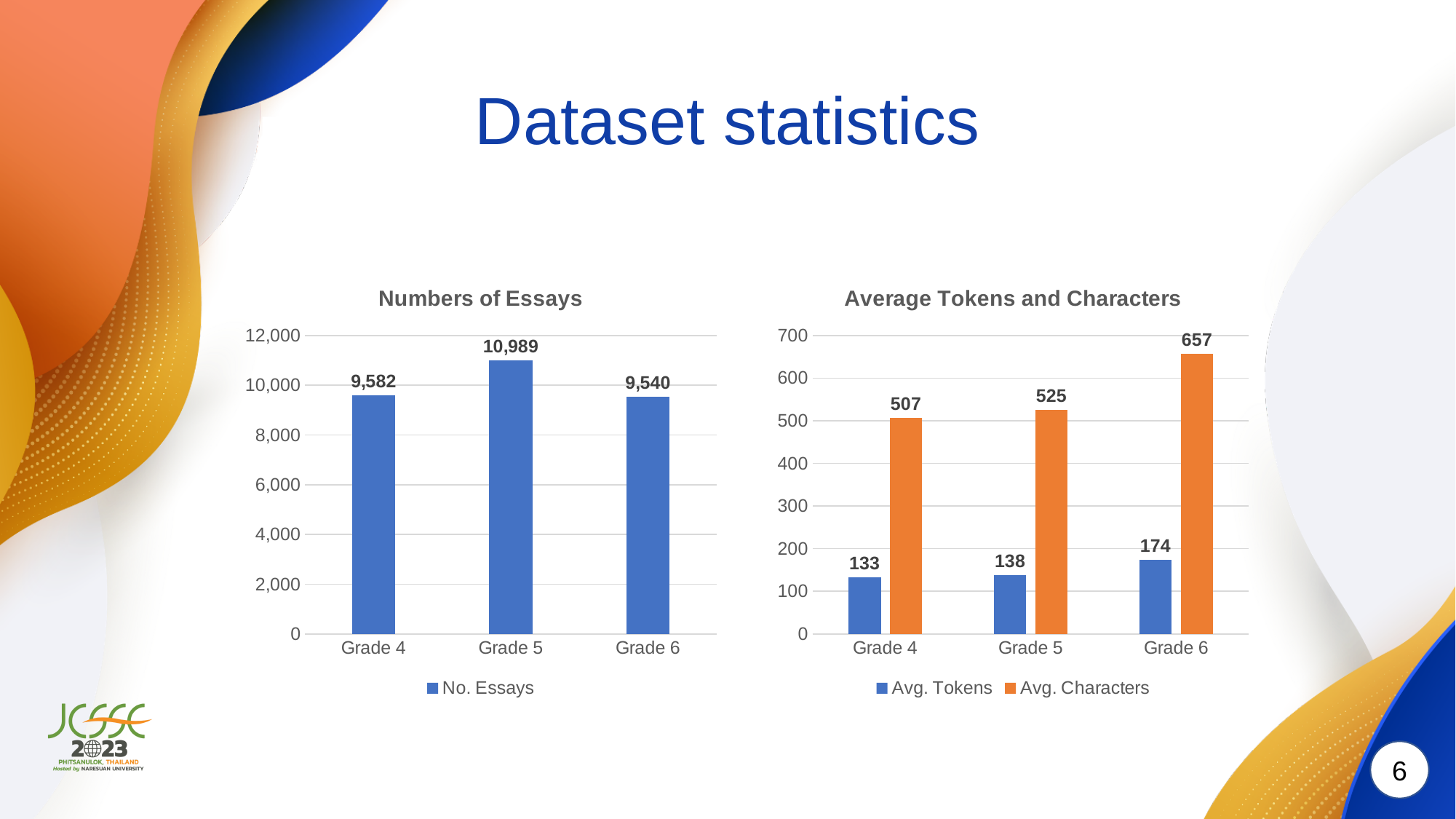
In the 'Average Tokens and Characters' chart, what is the difference in Avg. Characters between Grade 6 and Grade 5? 132 In the 'Average Tokens and Characters' chart, which grade has the highest Avg. Tokens? Grade 6 In the 'Average Tokens and Characters' chart, do the Avg. Tokens values rise or fall from Grade 4 to Grade 6? Rise In the 'Average Tokens and Characters' chart, is the Avg. Characters value for Grade 4 larger than the Avg. Tokens value for Grade 4? Yes In the 'Numbers of Essays' chart, how many grades are shown? 3 What kind of chart is the 'Numbers of Essays' chart? Bar chart In the 'Numbers of Essays' chart, what is the difference between Grade 5 and Grade 4? 1,407 In the 'Numbers of Essays' chart, what is the value for Grade 5? 10,989 In the 'Average Tokens and Characters' chart, how many series does the legend list? 2 In the 'Numbers of Essays' chart, which grade has the lowest number of essays? Grade 6 In the 'Average Tokens and Characters' chart, what is the Avg. Characters value for Grade 6? 657 In the 'Average Tokens and Characters' chart, what is the Avg. Tokens value for Grade 4? 133